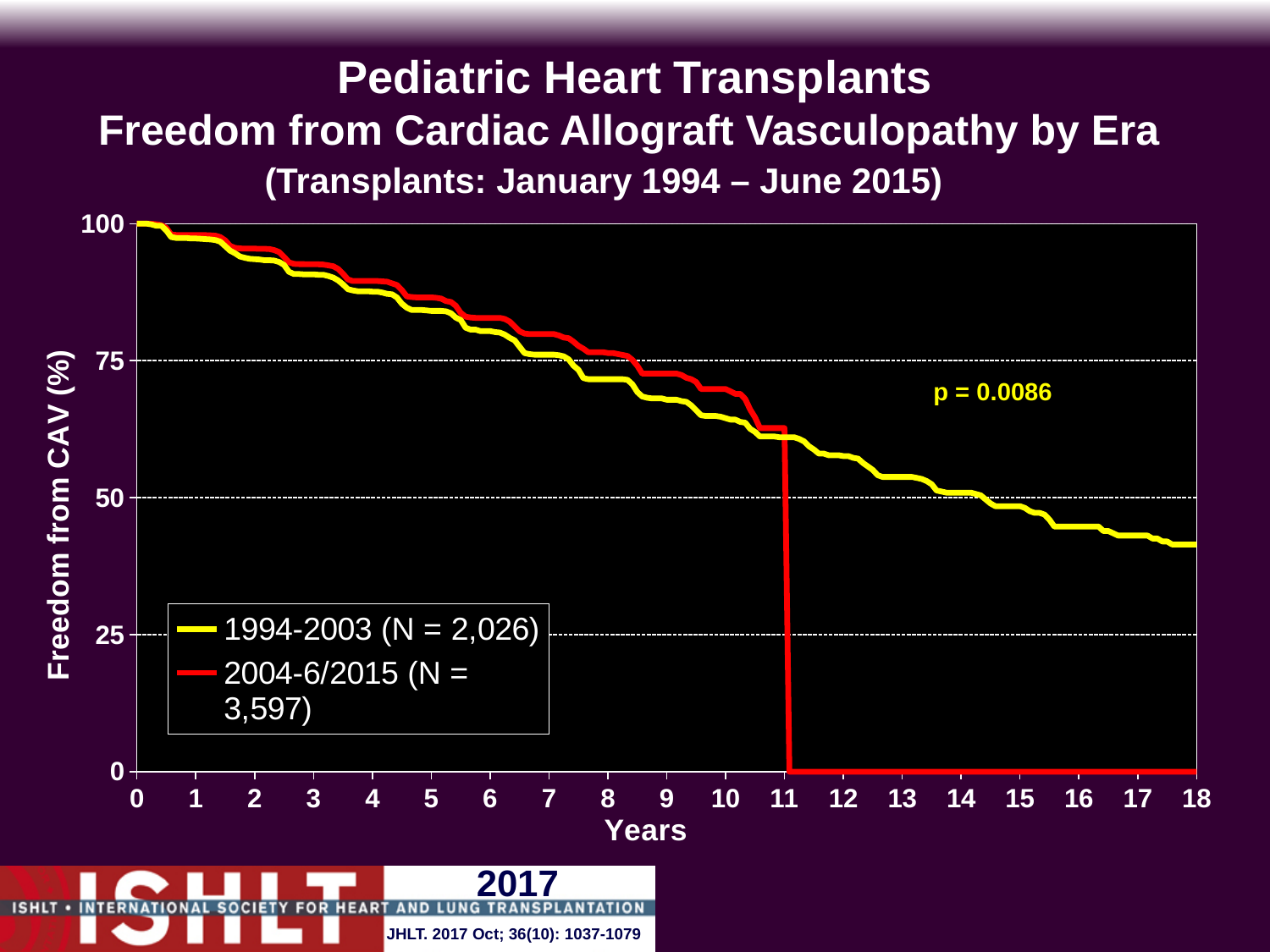
What kind of chart is shown on the slide? line chart Does freedom from CAV for the 2004-6/2015 era rise or fall over the years shown? fall Is the value for the 1994-2003 era at year 5 greater or less than 75? greater At year 8, which era has the higher freedom from CAV, 1994-2003 or 2004-6/2015? 2004-6/2015 Is the value for the 1994-2003 era at year 16 greater or less than 50? less What p-value is printed on the chart? p = 0.0086 How many series does the legend list? 2 Is the value for the 2004-6/2015 era at year 5 greater or less than 75? greater What is the N shown in the legend for the 2004-6/2015 era? 3,597 Does freedom from CAV for the 1994-2003 era rise or fall as years increase? fall